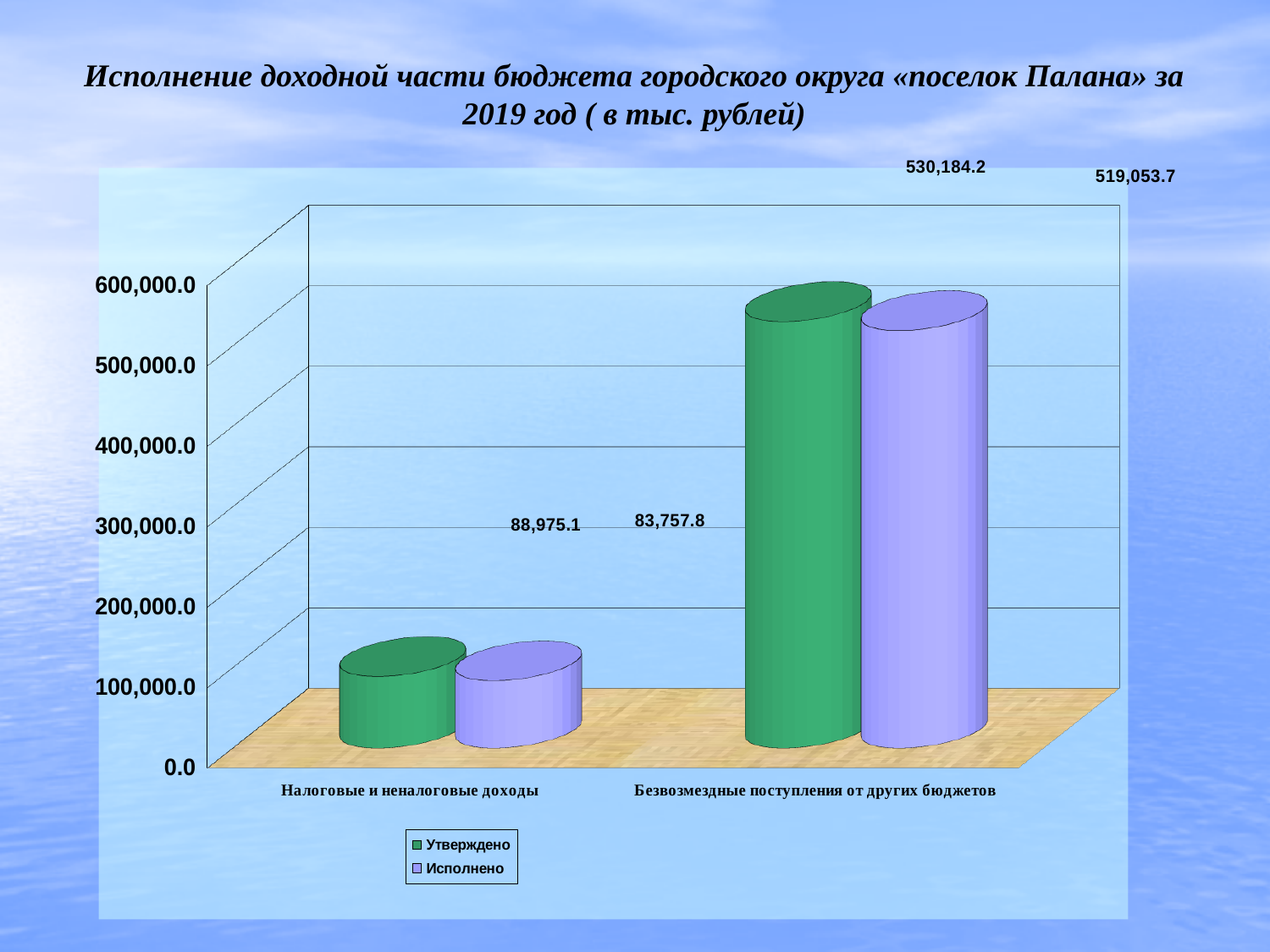
What is the Исполнено value for Безвозмездные поступления от других бюджетов? 519,053.7 For Безвозмездные поступления от других бюджетов, which is larger: Утверждено or Исполнено? Утверждено What is the Исполнено value for Налоговые и неналоговые доходы? 83,757.8 Which category has the highest Исполнено value? Безвозмездные поступления от других бюджетов What is the Утверждено value for Безвозмездные поступления от других бюджетов? 530,184.2 What is the difference between the Утверждено and Исполнено values for Налоговые и неналоговые доходы? 5,217.3 Which category has the lowest Утверждено value? Налоговые и неналоговые доходы What is the Утверждено value for Налоговые и неналоговые доходы? 88,975.1 What kind of chart is shown on the slide? Bar chart What is the difference between the Утверждено and Исполнено values for Безвозмездные поступления от других бюджетов? 11,130.5 How many series does the legend list? 2 How many categories are shown on the x axis? 2